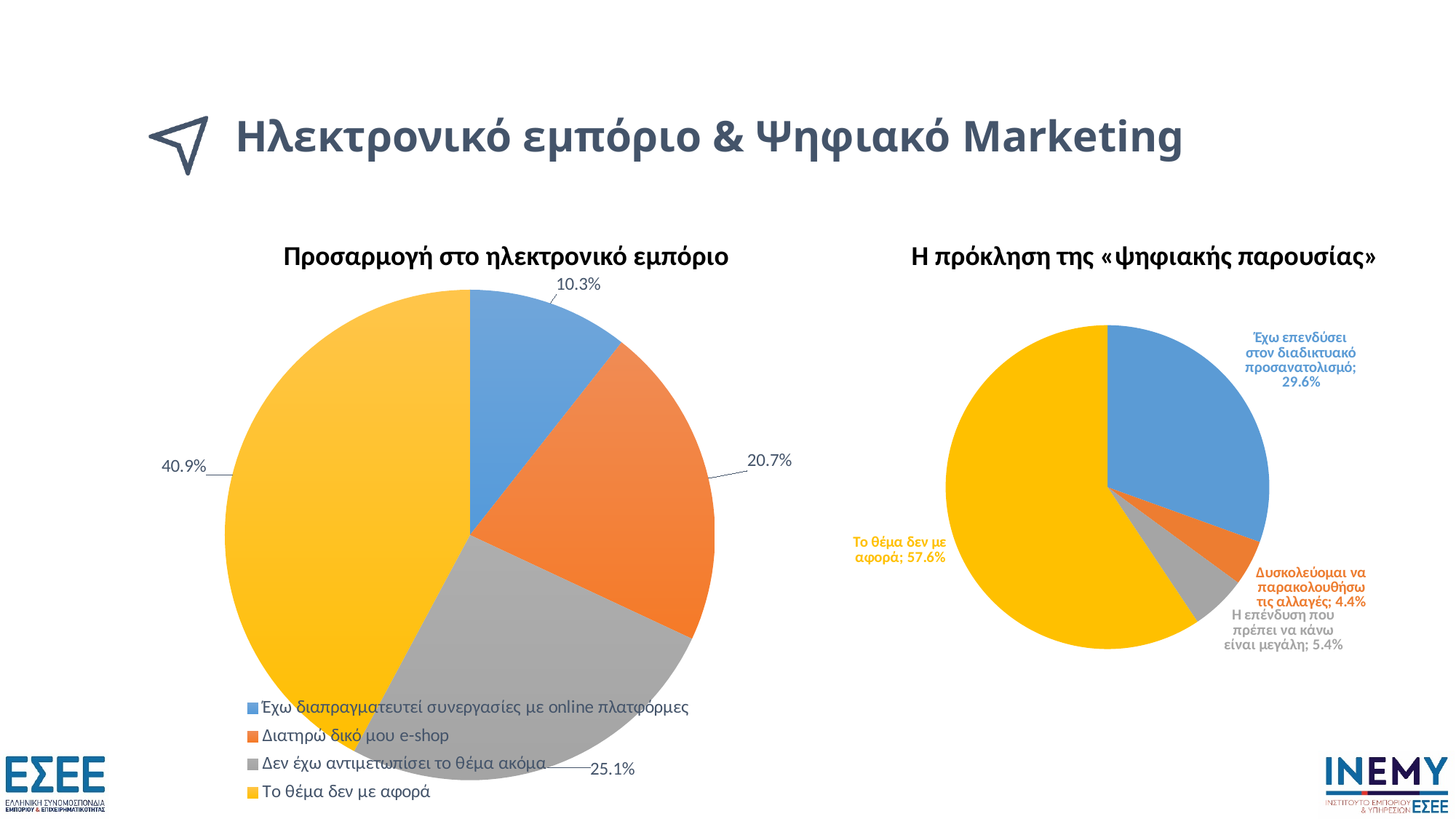
In the chart titled «Προσαρμογή στο ηλεκτρονικό εμπόριο», which category has the smallest slice? Έχω διαπραγματευτεί συνεργασίες με online πλατφόρμες In the chart titled «Προσαρμογή στο ηλεκτρονικό εμπόριο», what share is shown for «Το θέμα δεν με αφορά»? 40.9% In the chart titled «Προσαρμογή στο ηλεκτρονικό εμπόριο», what share is shown for «Διατηρώ δικό μου e-shop»? 20.7% In the chart titled «Προσαρμογή στο ηλεκτρονικό εμπόριο», what is the difference in percentage points between «Δεν έχω αντιμετωπίσει το θέμα ακόμα» and «Διατηρώ δικό μου e-shop»? 4.4 percentage points In the chart titled «Προσαρμογή στο ηλεκτρονικό εμπόριο», what colour is the slice for «Δεν έχω αντιμετωπίσει το θέμα ακόμα»? Gray In the chart titled «Η πρόκληση της «ψηφιακής παρουσίας»», what share is shown for «Έχω επενδύσει στον διαδικτυακό προσανατολισμό»? 29.6% How many categories does the legend of the chart titled «Προσαρμογή στο ηλεκτρονικό εμπόριο» list? 4 In the chart titled «Η πρόκληση της «ψηφιακής παρουσίας»», which is larger: «Η επένδυση που πρέπει να κάνω είναι μεγάλη» or «Δυσκολεύομαι να παρακολουθήσω τις αλλαγές»? Η επένδυση που πρέπει να κάνω είναι μεγάλη In the chart titled «Προσαρμογή στο ηλεκτρονικό εμπόριο», which category has the largest slice? Το θέμα δεν με αφορά In the chart titled «Η πρόκληση της «ψηφιακής παρουσίας»», which category has the largest slice? Το θέμα δεν με αφορά What type of chart is the chart titled «Η πρόκληση της «ψηφιακής παρουσίας»»? Pie chart